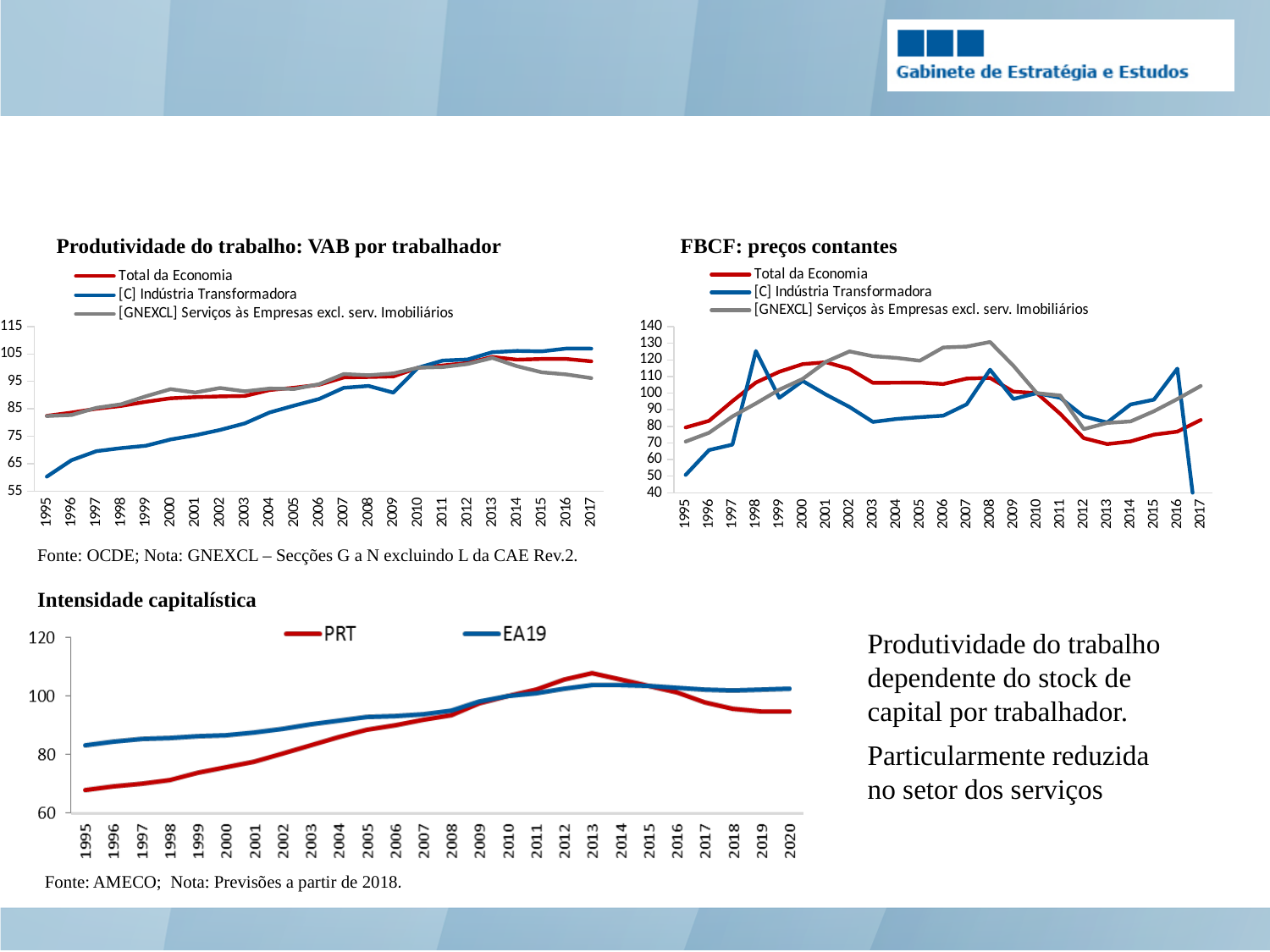
In the 'Intensidade capitalística' chart, which series has the larger value in 1995, PRT or EA19? EA19 In the 'FBCF: preços contantes' chart, is the value for '[C] Indústria Transformadora' in 2017 greater or less than 50? less In the 'Produtividade do trabalho: VAB por trabalhador' chart, in which year is the '[C] Indústria Transformadora' series lowest? 1995 In the 'Intensidade capitalística' chart, is the value for PRT in 1995 greater or less than 80? less How many series does the legend of the 'Produtividade do trabalho: VAB por trabalhador' chart list? 3 In the 'Produtividade do trabalho: VAB por trabalhador' chart, does the '[C] Indústria Transformadora' series generally rise or fall from 1995 to 2017? Rise What kind of chart is the 'Intensidade capitalística' chart? Line chart How many series does the legend of the 'Intensidade capitalística' chart list? 2 How many years are shown on the x axis of the 'FBCF: preços contantes' chart? 23 How many years are shown on the x axis of the 'Intensidade capitalística' chart? 26 In the 'FBCF: preços contantes' chart, in which year does the '[GNEXCL] Serviços às Empresas excl. serv. Imobiliários' series reach its highest value? 2008 In the 'Intensidade capitalística' chart, in which year does the PRT series reach its highest value? 2013